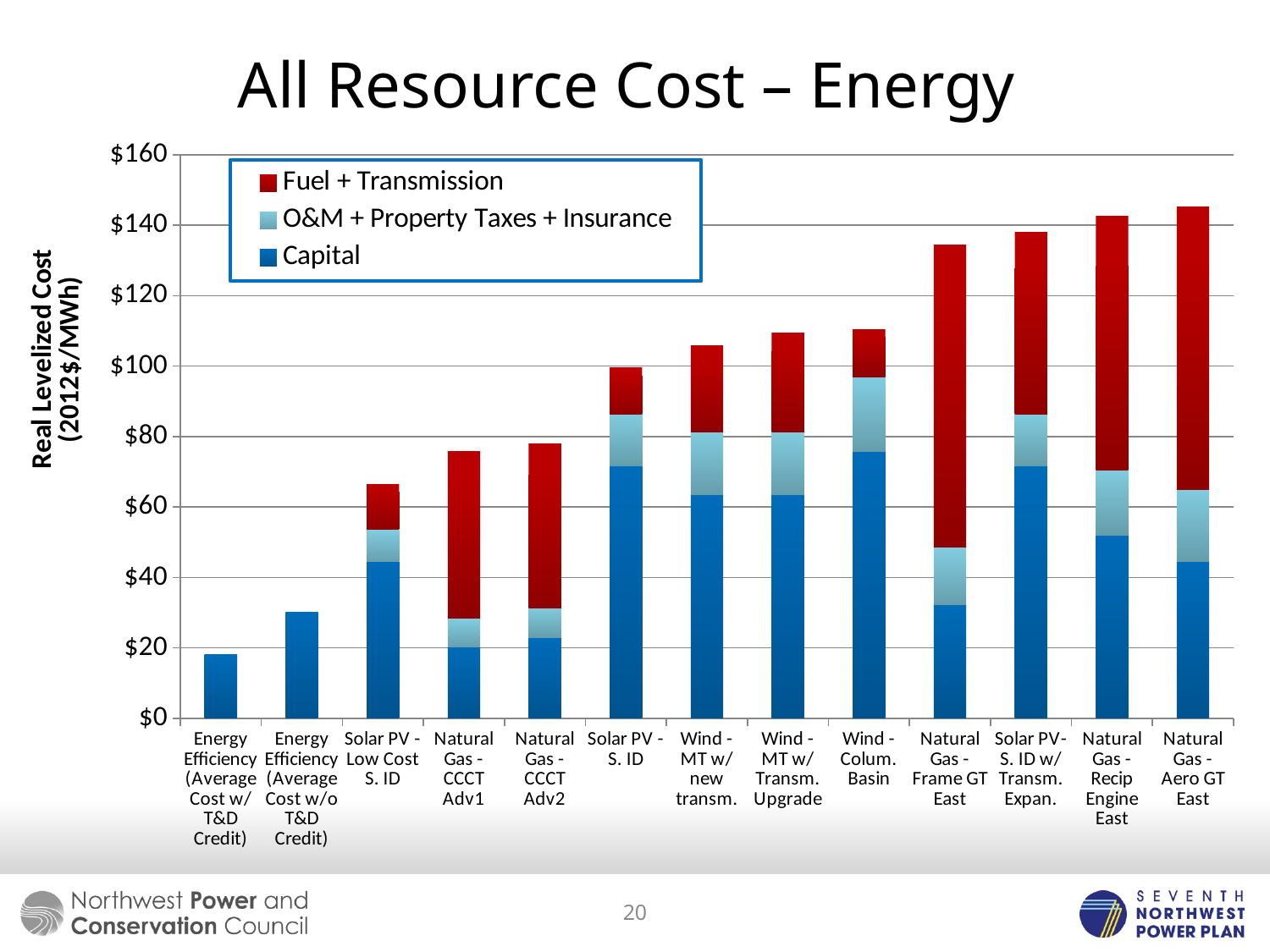
Which resource has the lowest total levelized cost? Energy Efficiency (Average Cost w/ T&D Credit) How many series does the legend list? 3 Which resource has the highest total levelized cost? Natural Gas - Aero GT East Which has a higher total levelized cost, Natural Gas - Frame GT East or Wind - Colum. Basin? Natural Gas - Frame GT East What is the title of the chart? All Resource Cost – Energy How many resource categories are plotted along the x axis? 13 Is the total value for Natural Gas - Aero GT East greater or less than $140? greater Do the total bar heights generally rise or fall from left to right along the x axis? Rise Is the total value for Wind - Colum. Basin greater or less than $100? greater What kind of chart is shown on the slide? Stacked bar chart Is the total value for Energy Efficiency (Average Cost w/ T&D Credit) greater or less than $40? less